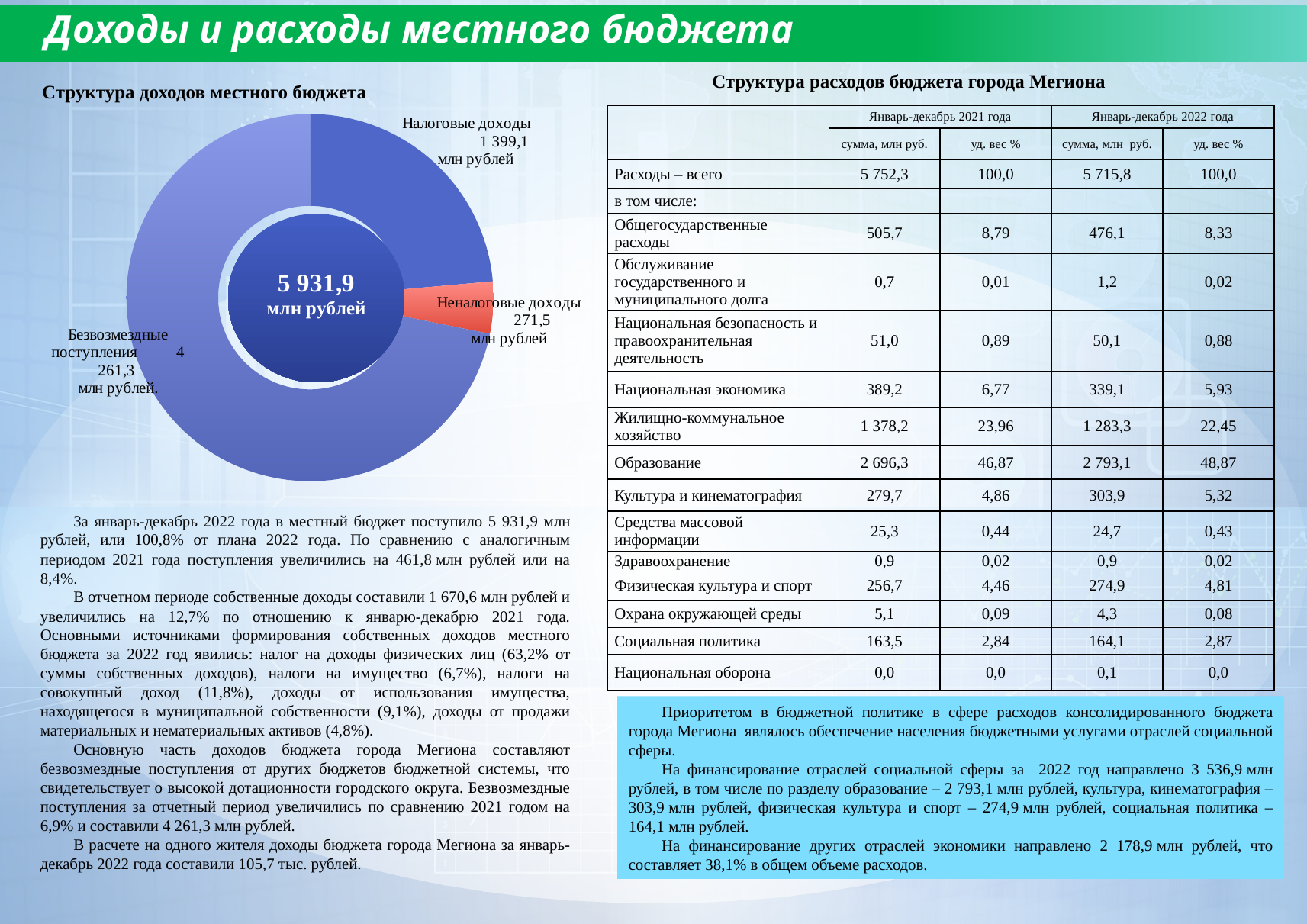
Какая категория доходов на диаграмме структуры доходов местного бюджета является наименьшей? Неналоговые доходы Какова величина налоговых доходов на диаграмме структуры доходов местного бюджета? 1 399,1 млн рублей Какая категория доходов на диаграмме структуры доходов местного бюджета является наибольшей? Безвозмездные поступления Какова величина неналоговых доходов на диаграмме структуры доходов местного бюджета? 271,5 млн рублей Каким цветом на диаграмме структуры доходов местного бюджета выделены неналоговые доходы? Красным Какой тип диаграммы использован для структуры доходов местного бюджета? Кольцевая диаграмма Какая общая сумма доходов указана в центре диаграммы структуры доходов местного бюджета? 5 931,9 млн рублей Какова величина безвозмездных поступлений на диаграмме структуры доходов местного бюджета? 4 261,3 млн рублей Сколько категорий доходов показано на диаграмме «Структура доходов местного бюджета»? 3 Что больше на диаграмме структуры доходов местного бюджета: налоговые доходы или неналоговые доходы? Налоговые доходы На сколько безвозмездные поступления превышают налоговые доходы на диаграмме структуры доходов местного бюджета? 2 862,2 млн рублей На сколько налоговые доходы превышают неналоговые доходы на диаграмме структуры доходов местного бюджета? 1 127,6 млн рублей